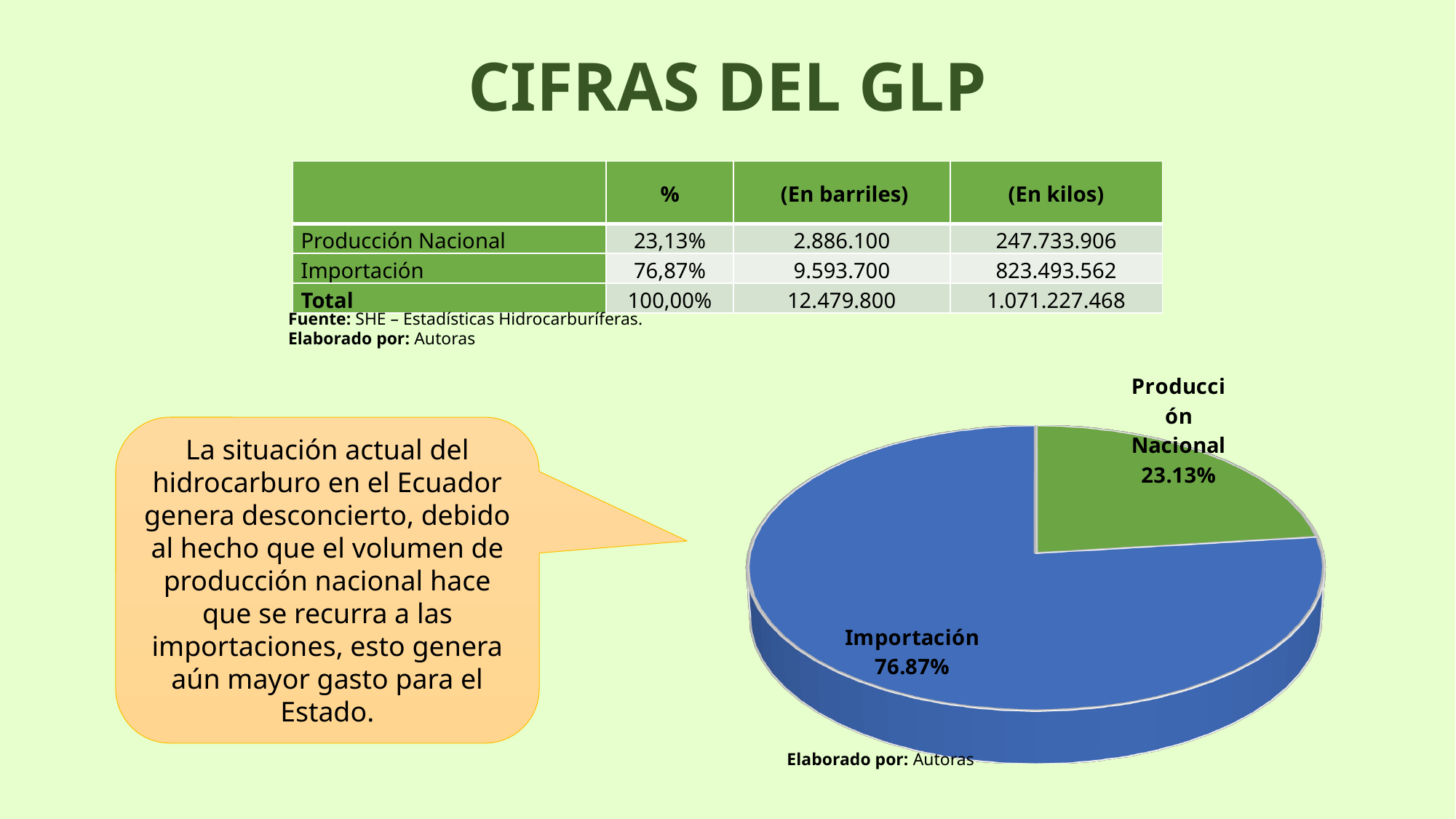
What kind of chart is shown on the slide? Pie chart Which is larger in the pie chart, Importación or Producción Nacional? Importación What colour is the Producción Nacional slice in the pie chart? Green What share of the pie chart does Importación represent? 76.87% What colour is the Importación slice in the pie chart? Blue Which slice of the pie chart is the largest? Importación How many slices does the pie chart have? 2 Which slice of the pie chart is the smallest? Producción Nacional What is the difference in percentage points between the Importación and Producción Nacional slices? 53.74 What share of the pie chart does Producción Nacional represent? 23.13%